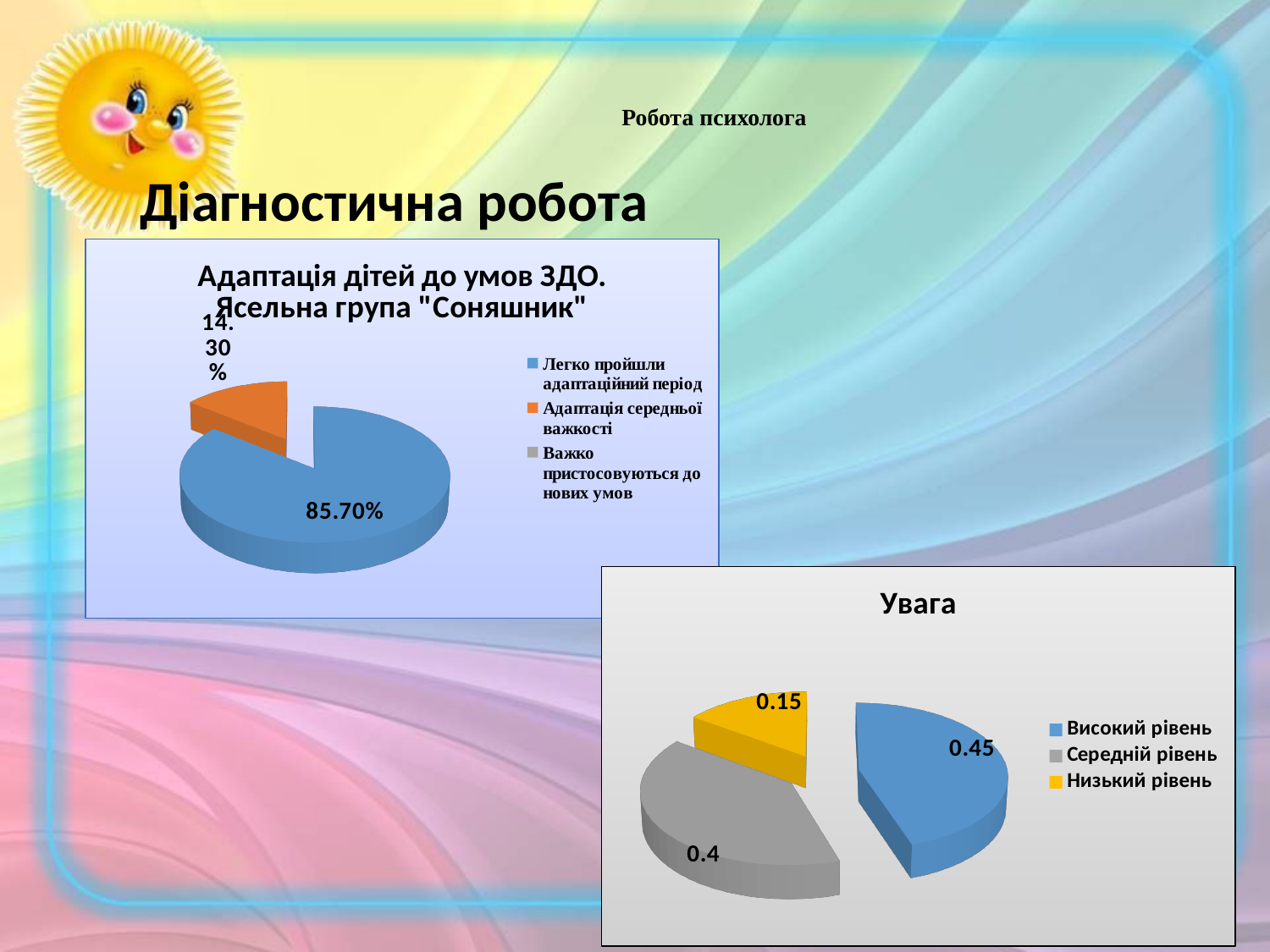
In the chart titled "Адаптація дітей до умов ЗДО. Ясельна група "Соняшник"", what colour is the slice for Адаптація середньої важкості? Orange What kind of chart is the chart titled "Увага"? Pie chart In the chart titled "Увага", which category has the lowest value? Низький рівень In the chart titled "Увага", what is the value for Середній рівень? 0.4 In the chart titled "Увага", what is the difference between the values for Високий рівень and Низький рівень? 0.3 In the chart titled "Адаптація дітей до умов ЗДО. Ясельна група "Соняшник"", which category has the highest value? Легко пройшли адаптаційний період In the chart titled "Увага", which is larger: the value for Середній рівень or the value for Низький рівень? Середній рівень In the chart titled "Адаптація дітей до умов ЗДО. Ясельна група "Соняшник"", what is the value for Легко пройшли адаптаційний період? 85.70% In the chart titled "Увага", what is the value for Низький рівень? 0.15 In the chart titled "Адаптація дітей до умов ЗДО. Ясельна група "Соняшник"", what is the value for Адаптація середньої важкості? 14.30% In the chart titled "Увага", what is the value for Високий рівень? 0.45 In the chart titled "Увага", how many entries does the legend list? 3